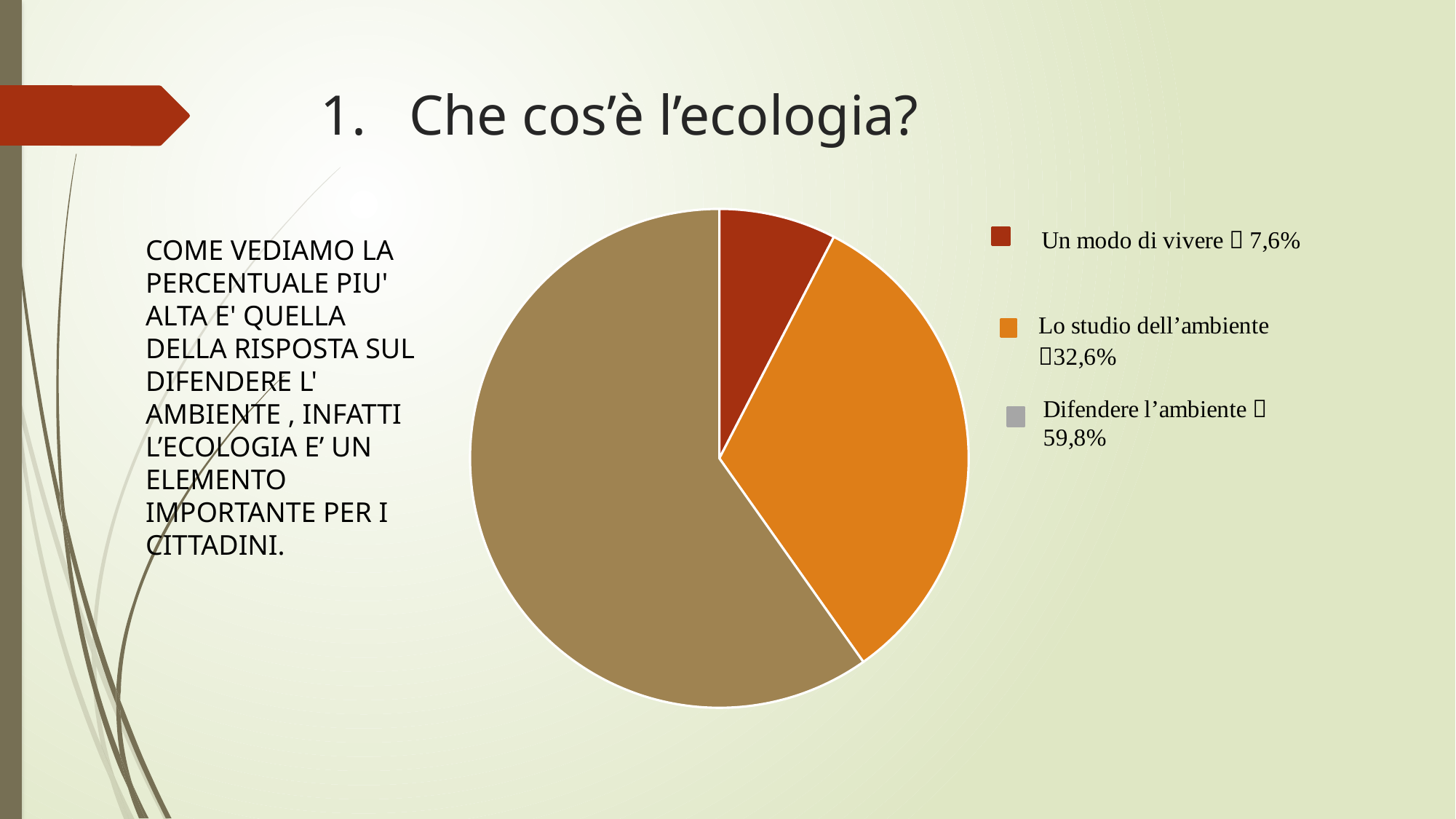
What percentage is given for "Un modo di vivere"? 7,6% What kind of chart is shown on the slide? pie chart Which category has the largest share of the pie? Difendere l'ambiente How many entries does the legend of the pie chart list? 3 What is the difference in percentage points between "Lo studio dell'ambiente" and "Un modo di vivere"? 25 How many slices does the pie chart have? 3 Which is larger, the share for "Lo studio dell'ambiente" or the share for "Un modo di vivere"? Lo studio dell'ambiente Which category has the smallest share of the pie? Un modo di vivere Which category is shown in orange in the pie chart? Lo studio dell'ambiente What percentage is given for "Lo studio dell'ambiente"? 32,6% What percentage is given for "Difendere l'ambiente"? 59,8% What is the difference in percentage points between "Difendere l'ambiente" and "Lo studio dell'ambiente"? 27,2